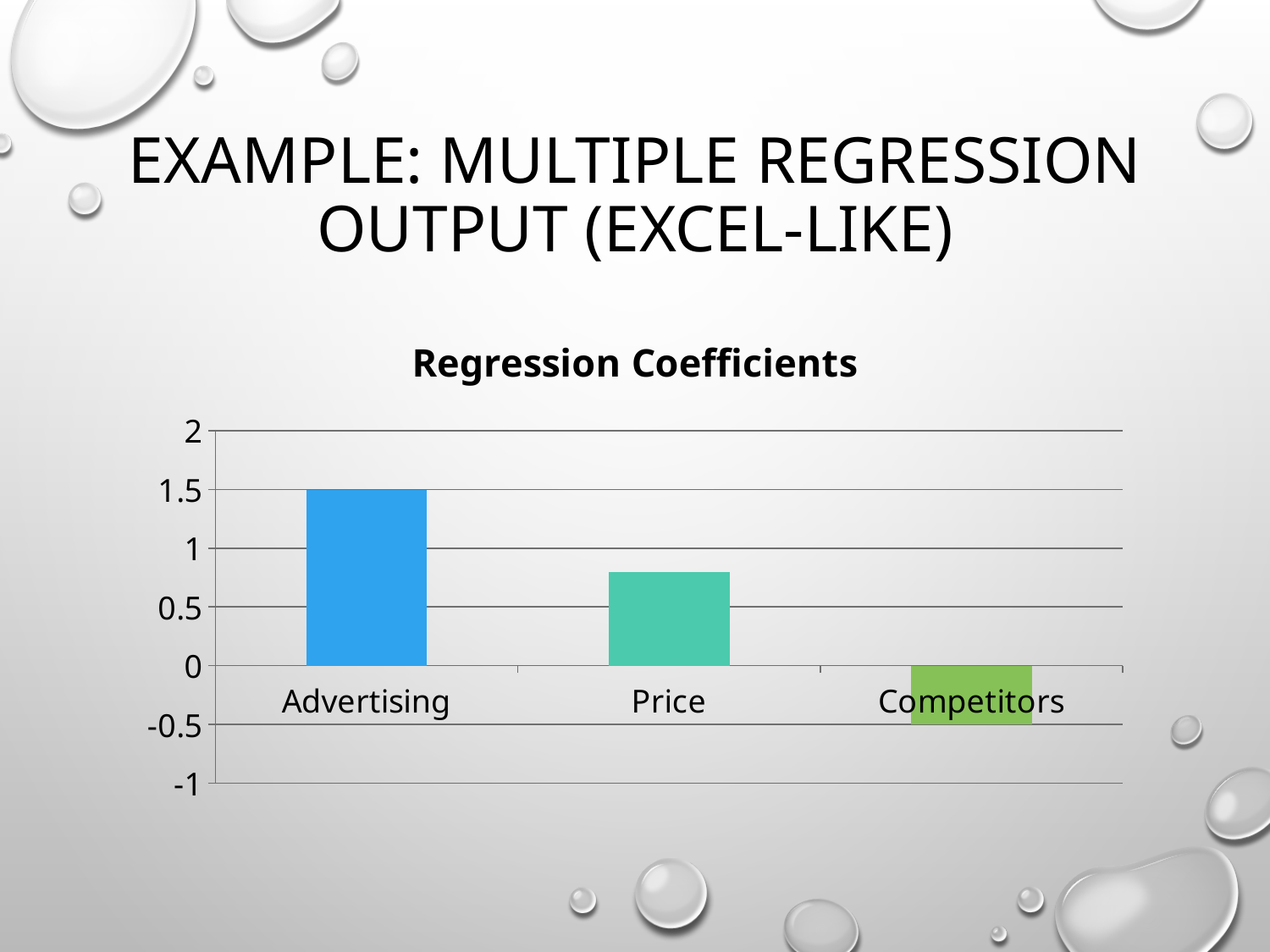
What is the regression coefficient for Competitors? -0.5 What is the title of the chart? Regression Coefficients Which category has the highest coefficient? Advertising Do the coefficients rise or fall from left to right across the categories? fall Which is larger, the coefficient for Advertising or for Price? Advertising What kind of chart is shown on the slide? bar chart Is the coefficient for Price greater or less than 1? less How many categories are shown on the x axis of the chart? 3 Is the coefficient for Price greater or less than 0.5? greater Which category has the lowest coefficient? Competitors What is the regression coefficient for Advertising? 1.5 What is the difference between the coefficients for Advertising and Competitors? 2